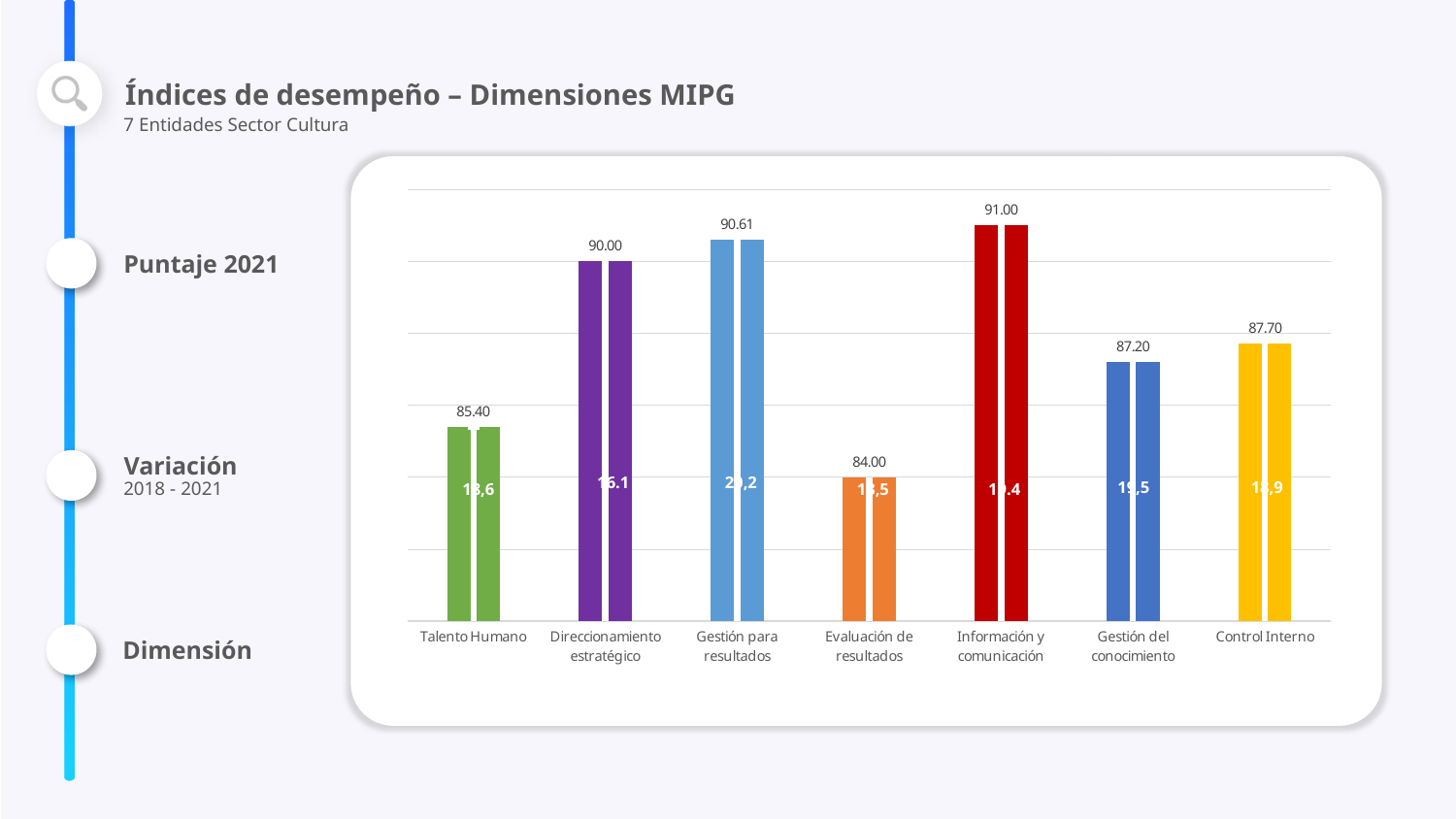
Which has a higher Puntaje 2021 value, Talento Humano or Gestión del conocimiento? Gestión del conocimiento What is the title of the slide containing the chart? Índices de desempeño – Dimensiones MIPG What is the Puntaje 2021 value for Talento Humano? 85.40 Which dimension has the highest Puntaje 2021 value? Información y comunicación What is the Puntaje 2021 value for Control Interno? 87.70 Which dimension has the lowest Puntaje 2021 value? Evaluación de resultados What kind of chart is shown on the slide? Bar chart What is the difference between the Puntaje 2021 values for Gestión para resultados and Direccionamiento estratégico? 0.61 What is the difference between the Puntaje 2021 values for Información y comunicación and Evaluación de resultados? 7.00 What is the Puntaje 2021 value for Gestión del conocimiento? 87.20 How many dimensions are shown on the x axis of the chart? 7 What is the Puntaje 2021 value for Información y comunicación? 91.00